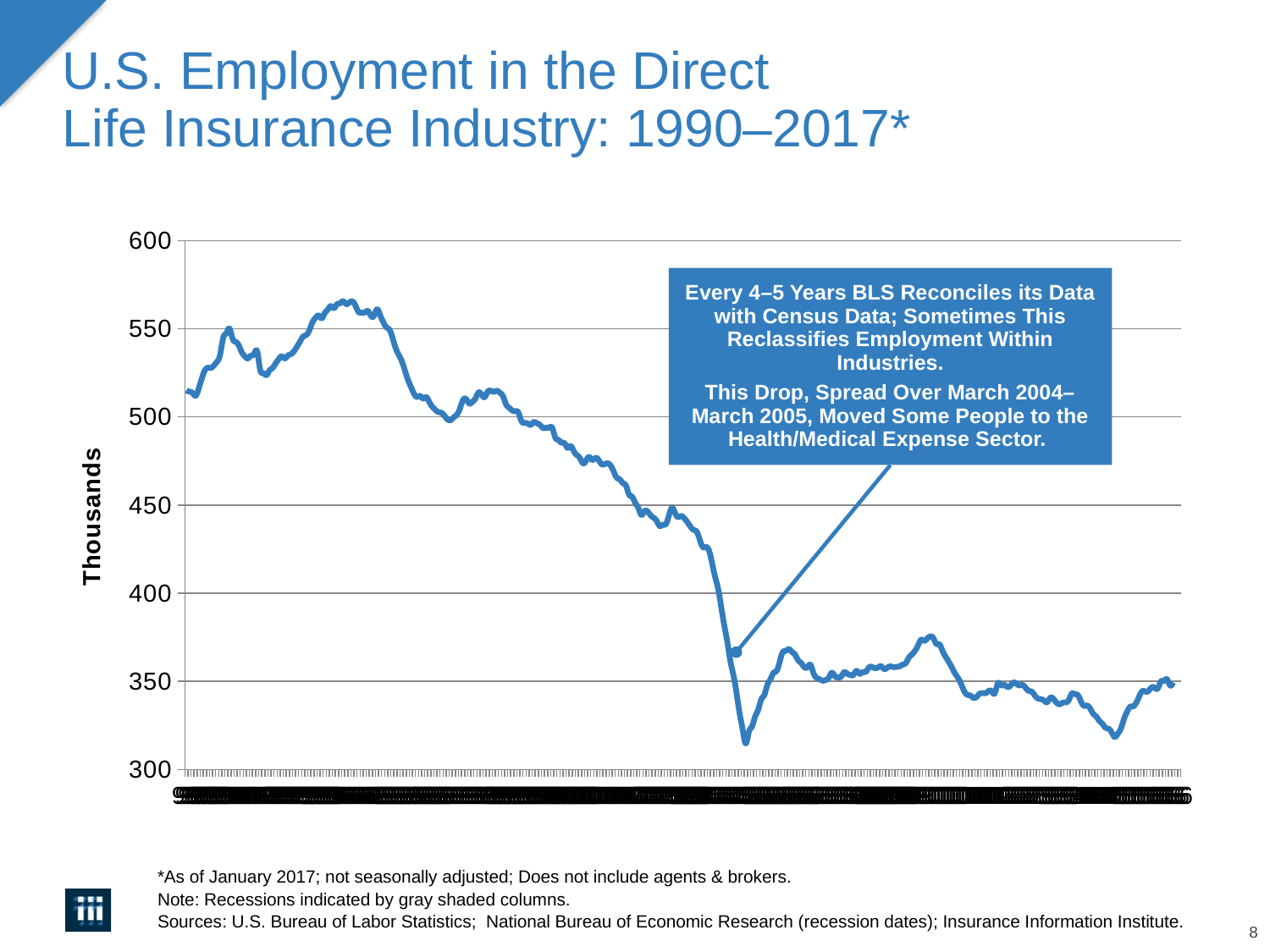
Is the value at the start of the line (left end) greater or less than 500? greater Overall, do the values on the line rise or fall from the left of the x axis to the right? Fall What is the highest value shown on the vertical axis? 600 What is the title of the chart on the slide? U.S. Employment in the Direct Life Insurance Industry: 1990–2017* What kind of chart is shown on the slide? Line chart What is the title of the vertical axis? Thousands Is the value at the end of the line (right end) greater or less than 300? greater Is the highest point on the line greater or less than 550? greater What is the lowest value shown on the vertical axis? 300